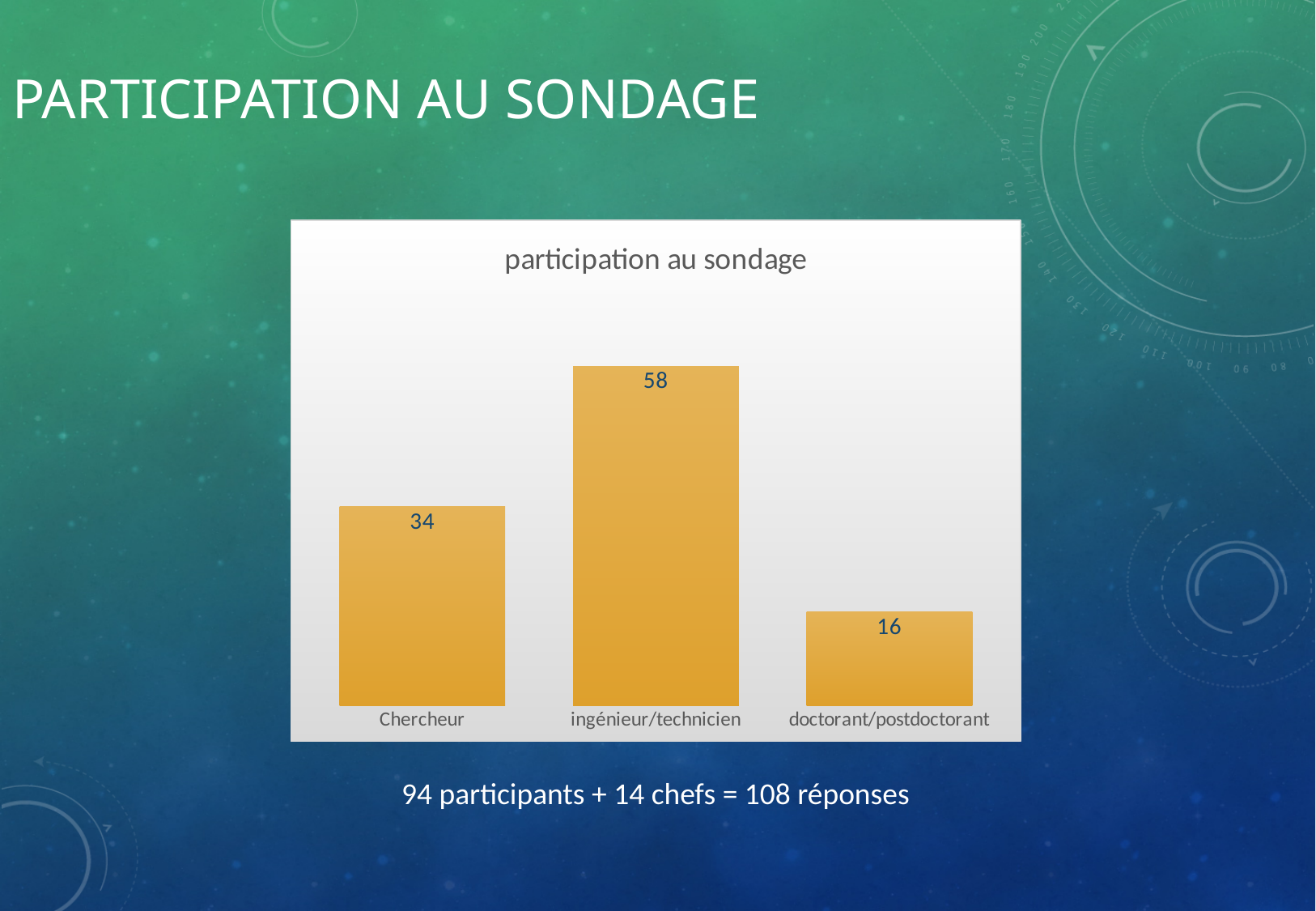
What is the value for ingénieur/technicien? 58 What kind of chart is shown on the slide? bar chart What is the title of the chart? participation au sondage Which is larger, the value for Chercheur or the value for doctorant/postdoctorant? Chercheur What is the difference between the values for ingénieur/technicien and Chercheur? 24 What colour are the bars in the chart? orange What is the value for doctorant/postdoctorant? 16 What is the difference between the values for Chercheur and doctorant/postdoctorant? 18 What is the value for Chercheur? 34 Which category has the highest value? ingénieur/technicien Which category has the lowest value? doctorant/postdoctorant How many categories are shown in the chart? 3